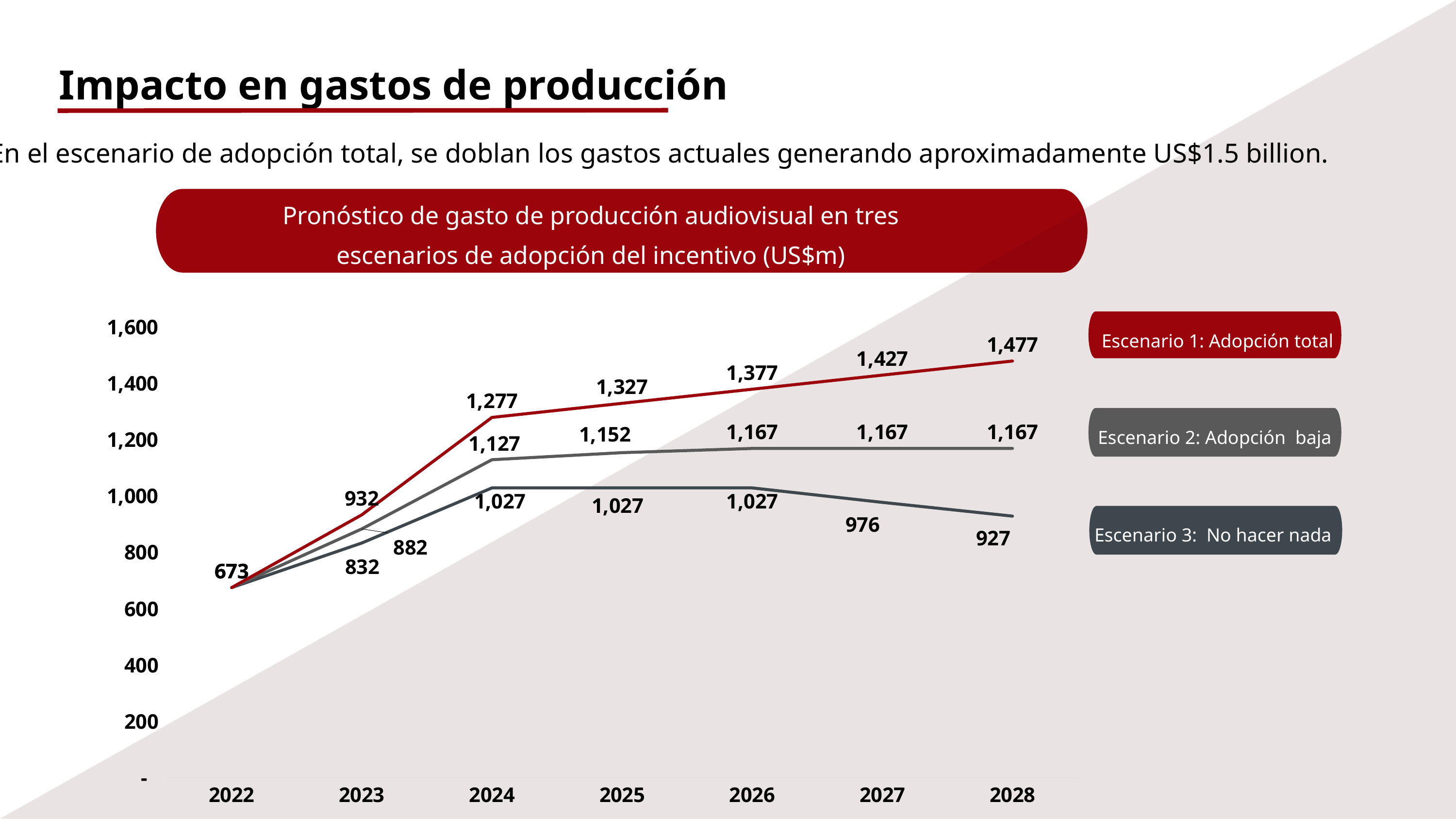
What is the difference between Escenario 1 and Escenario 3 in 2028? 550 What is the value shown for 2022, where all three scenarios start? 673 What is the value for Escenario 2: Adopción baja in 2024? 1,127 What type of chart is shown on the slide? line chart Which scenario has the lowest value in 2028? Escenario 3: No hacer nada How many years are shown on the x axis? 7 Which is larger in 2023: Escenario 1 at 932 or Escenario 2 at 882? Escenario 1 How many scenarios (series) does the legend list? 3 What is the value for Escenario 3: No hacer nada in 2027? 976 Which scenario has the highest value in 2028? Escenario 1: Adopción total Does the Escenario 3: No hacer nada line rise or fall between 2026 and 2028? fall What is the value for Escenario 1: Adopción total in 2028? 1,477